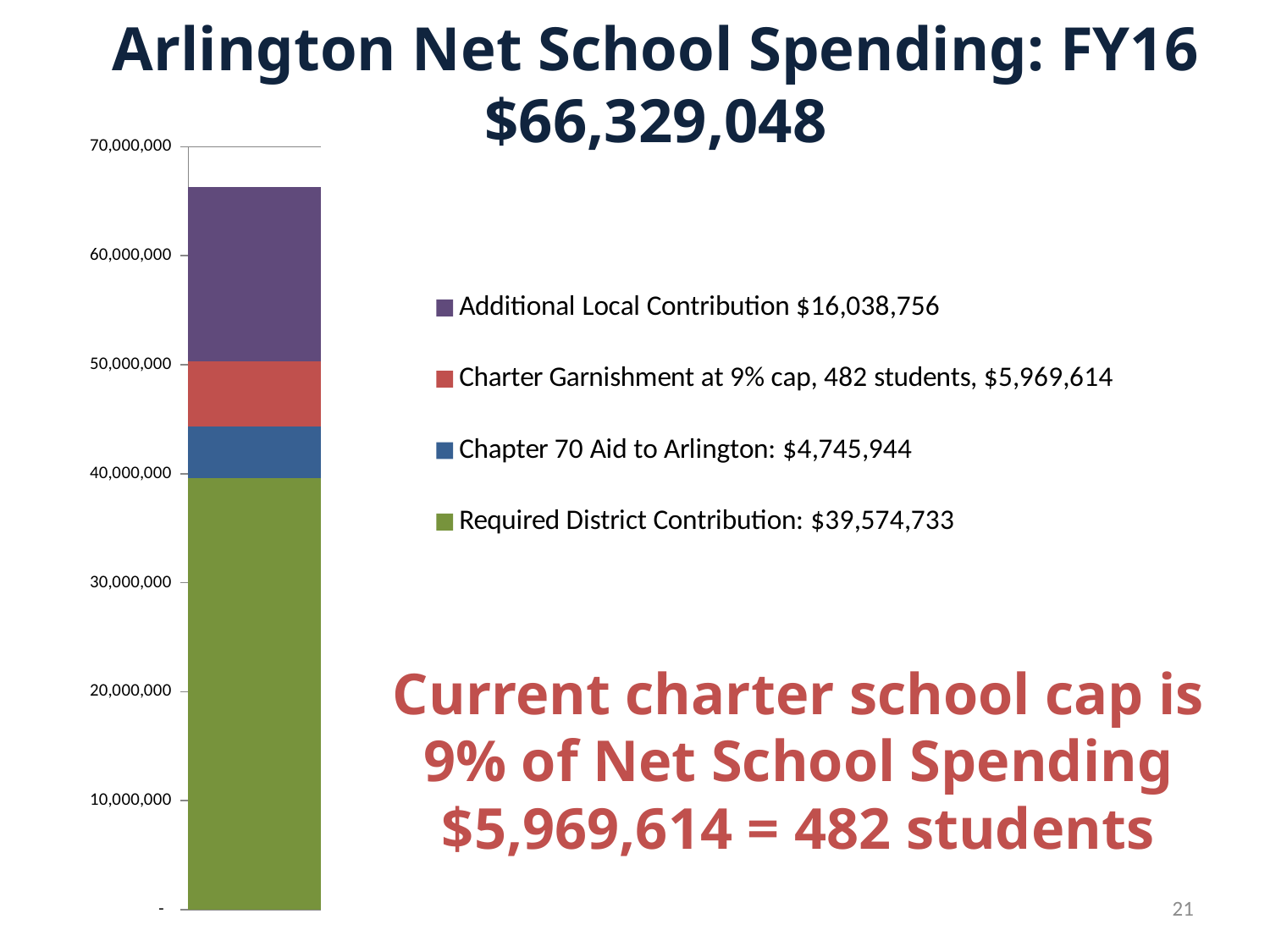
What is the value of Additional Local Contribution in the stacked bar? $16,038,756 Which is larger, Charter Garnishment or Chapter 70 Aid to Arlington? Charter Garnishment What is the value of Charter Garnishment at 9% cap? $5,969,614 What kind of chart is shown on the slide? Stacked bar chart Is the total height of the stacked bar greater or less than 60,000,000? greater How many series does the legend list? 4 Which segment of the stacked bar is the smallest? Chapter 70 Aid to Arlington What is the difference between Additional Local Contribution and Charter Garnishment? $10,069,142 What is the total of the stacked bar (Arlington Net School Spending FY16)? $66,329,048 What is the value of Required District Contribution? $39,574,733 Which segment of the stacked bar is the largest? Required District Contribution What is the value of Chapter 70 Aid to Arlington? $4,745,944